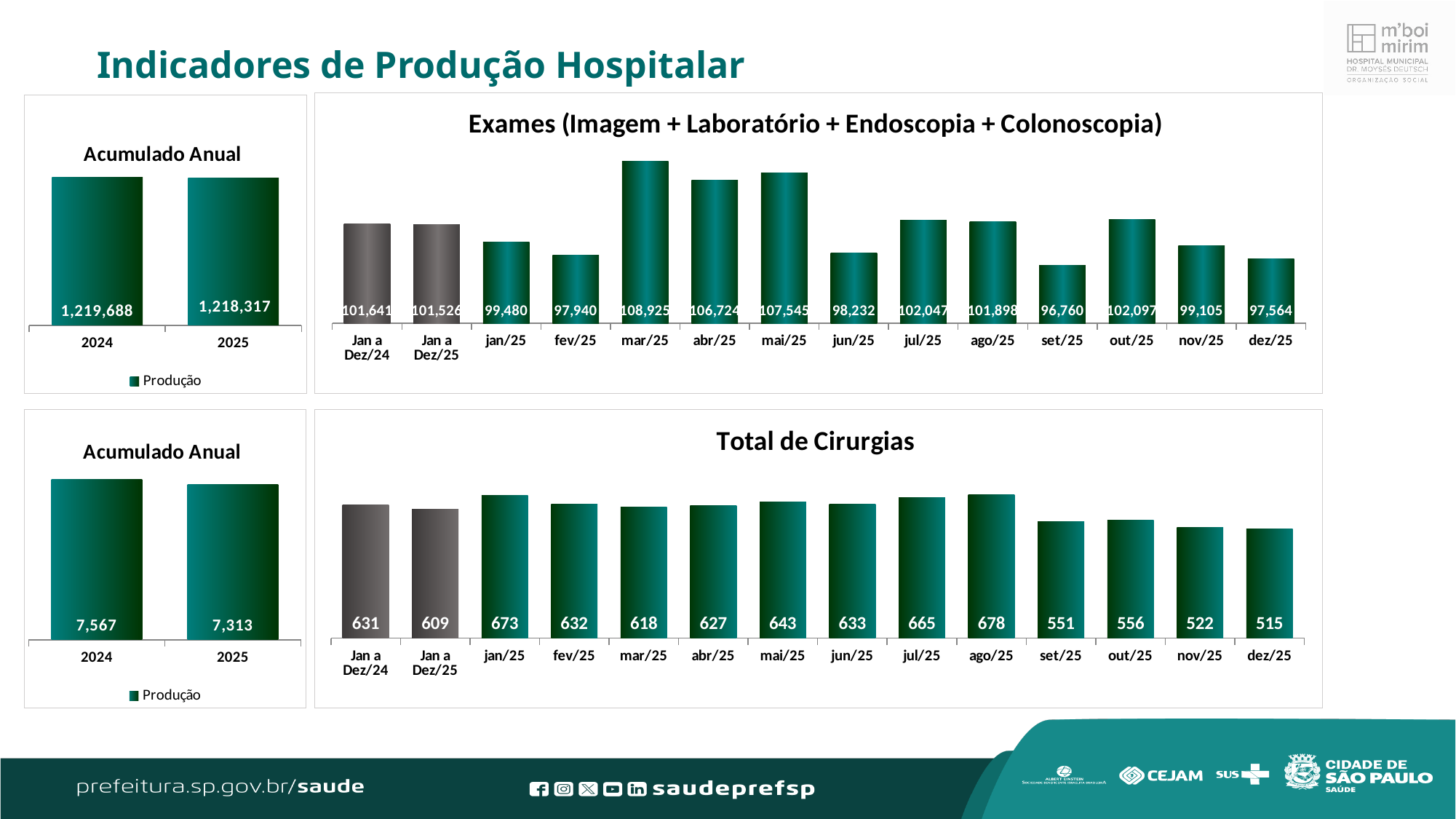
In the 'Total de Cirurgias' chart, what is the difference between the values for ago/25 and dez/25? 163 In the top-left 'Acumulado Anual' chart, what is the value for 2025? 1,218,317 In the 'Total de Cirurgias' chart, what is the value for ago/25? 678 In the 'Total de Cirurgias' chart, which month of 2025 has the highest value? ago/25 In the bottom-left 'Acumulado Anual' chart, what is the difference between the 2024 and 2025 values? 254 In the 'Exames (Imagem + Laboratório + Endoscopia + Colonoscopia)' chart, what is the value for mar/25? 108,925 In the 'Exames (Imagem + Laboratório + Endoscopia + Colonoscopia)' chart, which month of 2025 has the lowest value? set/25 What series name does the legend of the bottom-left 'Acumulado Anual' chart show? Produção How many bars are shown in the 'Total de Cirurgias' chart? 14 In the 'Total de Cirurgias' chart, which month of 2025 has the lowest value? dez/25 In the 'Exames (Imagem + Laboratório + Endoscopia + Colonoscopia)' chart, which is larger: the value for Jan a Dez/24 or Jan a Dez/25? Jan a Dez/24 What type of chart is the 'Exames (Imagem + Laboratório + Endoscopia + Colonoscopia)' chart? Bar chart